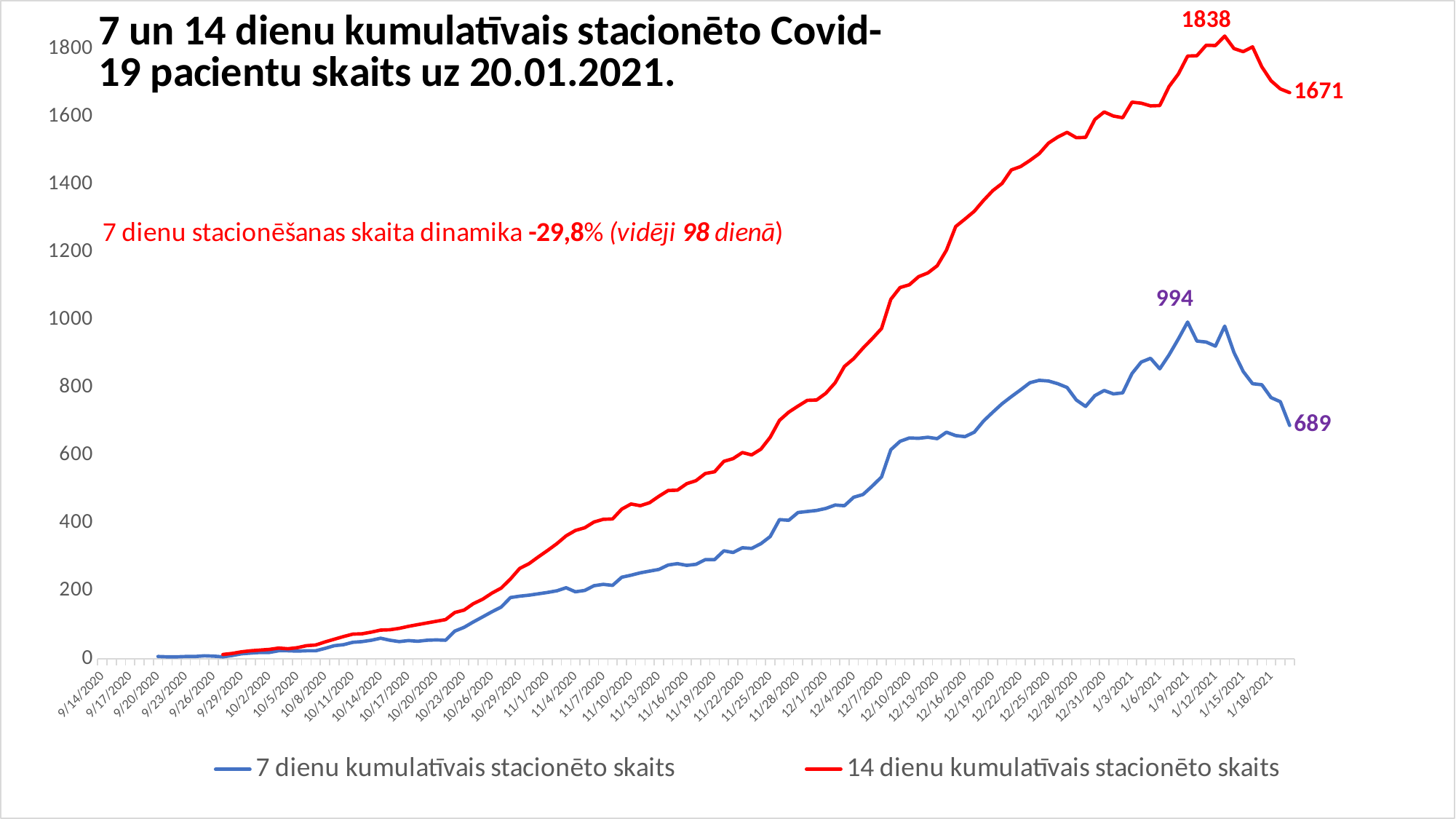
What is the final value labelled on the 7 dienu kumulatīvais stacionēto skaits line? 689 What is the peak value labelled on the 14 dienu kumulatīvais stacionēto skaits line? 1838 What is the difference between the final labelled values of the 14-day line (1671) and the 7-day line (689)? 982 What is the peak value labelled on the 7 dienu kumulatīvais stacionēto skaits line? 994 What is the final value labelled on the 14 dienu kumulatīvais stacionēto skaits line? 1671 Does the 7 dienu kumulatīvais stacionēto skaits line rise or fall between 1/9/2021 and 1/18/2021? fall What is the difference between the labelled peak (994) and the final labelled value (689) of the 7 dienu kumulatīvais stacionēto skaits line? 305 By how much did the 14 dienu kumulatīvais stacionēto skaits line fall from its labelled peak of 1838 to its final labelled value of 1671? 167 Which series has the higher value at the end of the chart, 7 dienu or 14 dienu kumulatīvais stacionēto skaits? 14 dienu kumulatīvais stacionēto skaits Is the value of the 7 dienu kumulatīvais stacionēto skaits line on 12/25/2020 greater or less than 600? greater How many series does the legend list? 2 What kind of chart is shown on the slide? line chart